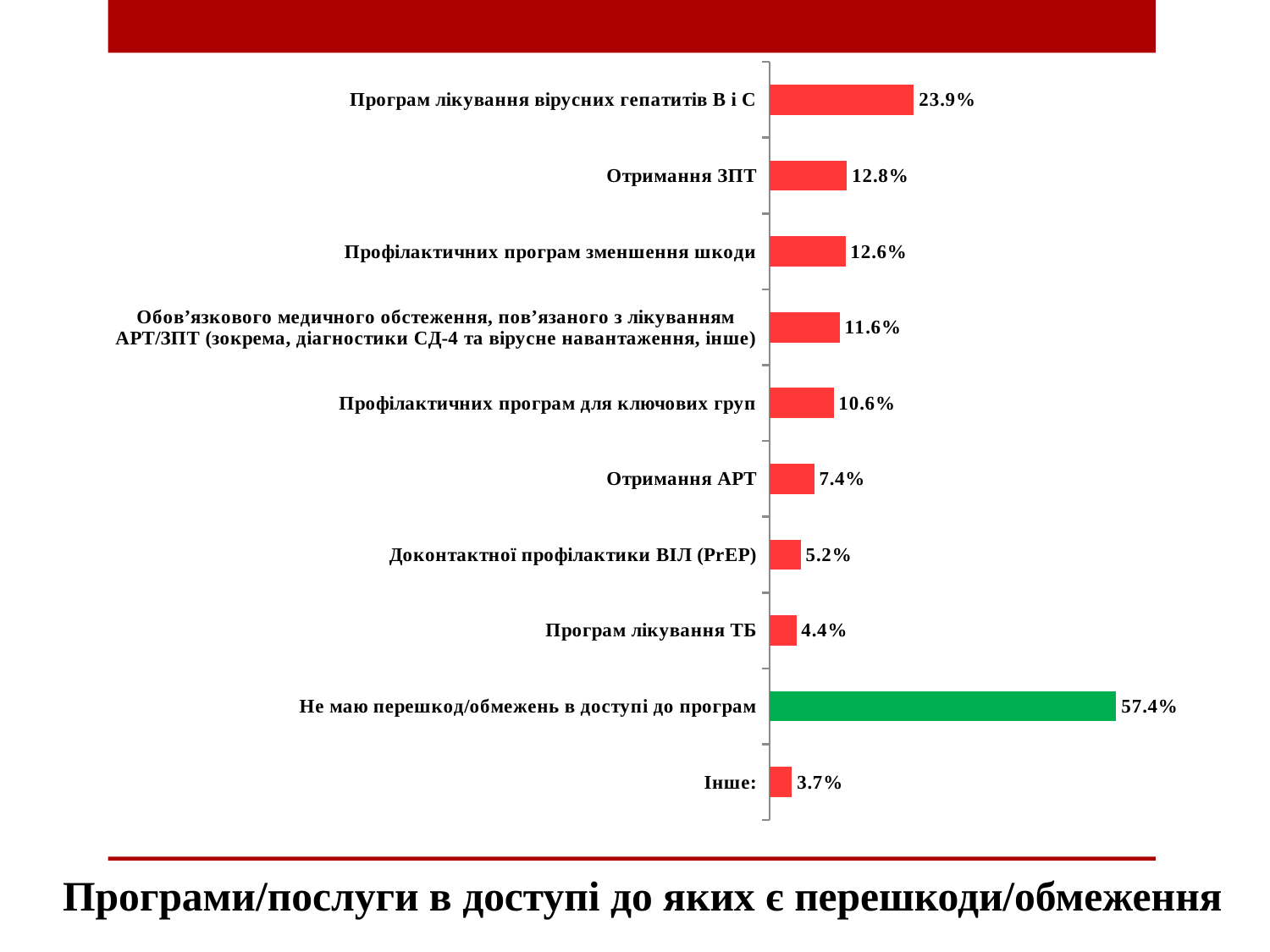
Which category has the highest value? Не маю перешкод/обмежень в доступі до програм Which bar is coloured green rather than red? Не маю перешкод/обмежень в доступі до програм What is the difference between the values for "Програм лікування вірусних гепатитів В і С" and "Профілактичних програм для ключових груп"? 13.3% Which category has the lowest value? Інше: What is the value for "Доконтактної профілактики ВІЛ (PrEP)"? 5.2% Which is larger: the value for "Отримання АРТ" or the value for "Програм лікування ТБ"? Отримання АРТ What is the value for "Програм лікування вірусних гепатитів В і С"? 23.9% What is the difference between the values for "Отримання ЗПТ" and "Профілактичних програм зменшення шкоди"? 0.2% What is the value for "Не маю перешкод/обмежень в доступі до програм"? 57.4% How many categories are shown in the chart? 10 What type of chart is shown on the slide? Bar chart What is the value for "Отримання ЗПТ"? 12.8%